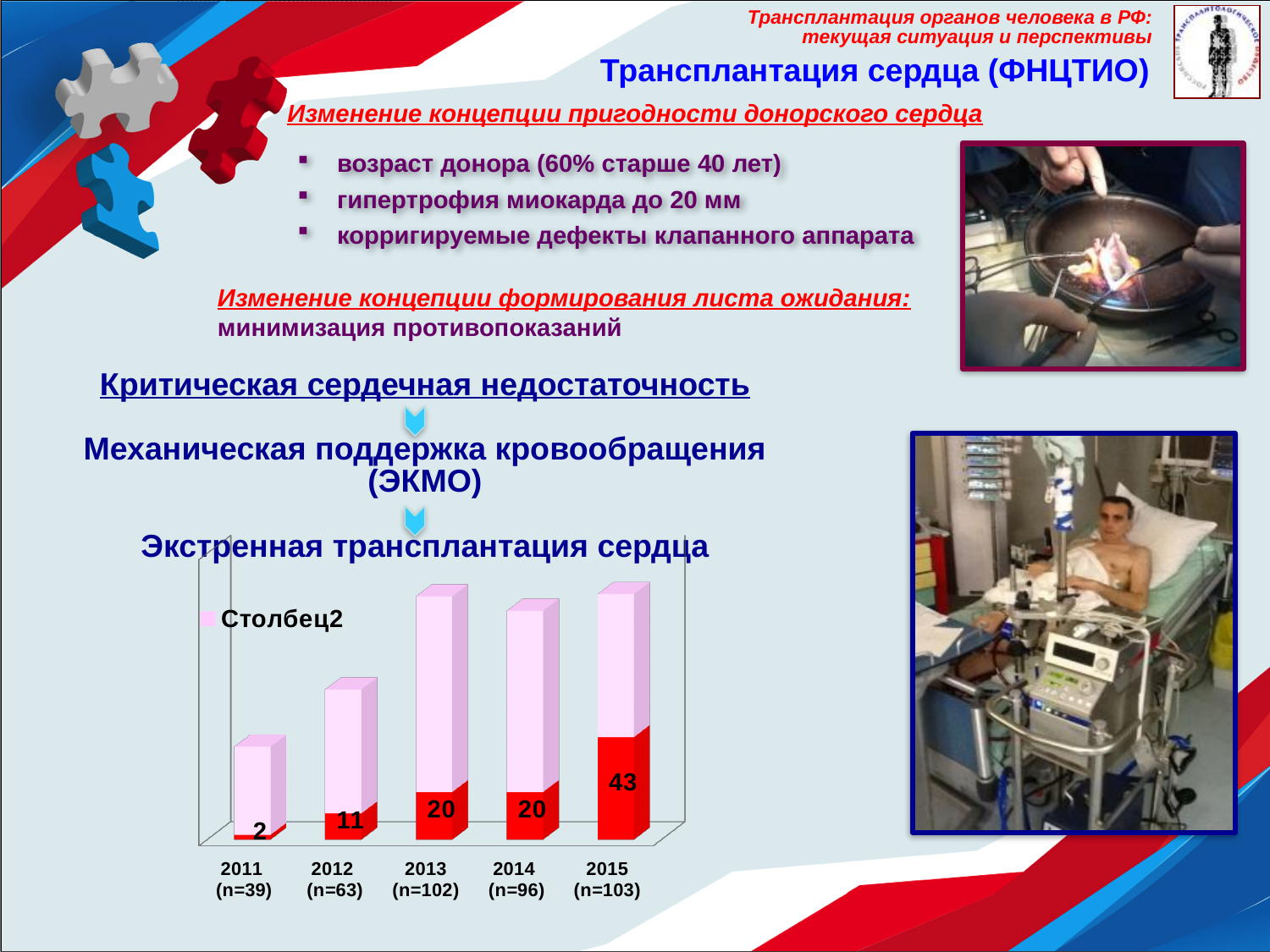
What is the difference between the red segment values for 2015 and 2014? 23 Which year has the lowest red segment value in the bar chart? 2011 (n=39) Which is larger, the red segment value for 2012 or for 2013? 2013 What is the red segment value for 2015 (n=103) in the bar chart? 43 What is the red segment value for 2011 (n=39) in the bar chart? 2 How many years are shown on the x axis of the bar chart? 5 Do the red segment values generally rise or fall from 2011 to 2015? Rise What is the red segment value for 2012 (n=63) in the bar chart? 11 Which year has the highest red segment value in the bar chart? 2015 (n=103) What is the red segment value for 2014 (n=96) in the bar chart? 20 What legend entry is shown in the bar chart? Столбец2 What kind of chart is shown on the slide? Stacked bar chart